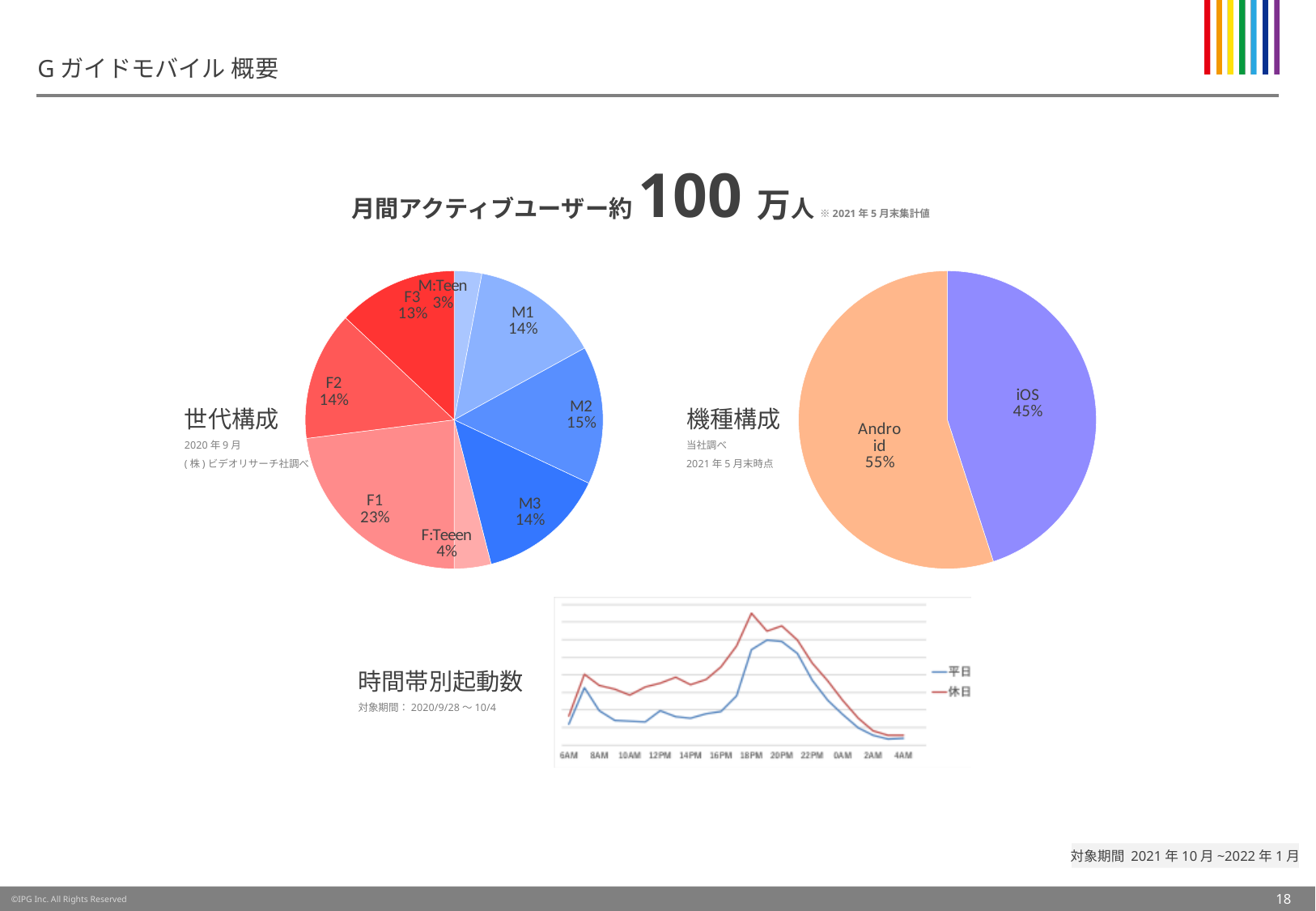
In the 世代構成 pie chart, what is the difference between the F1 share and the F3 share? 10% In the 機種構成 pie chart, what is the difference between the Android share and the iOS share? 10% How many series does the legend of the 時間帯別起動数 chart list? 2 In the 世代構成 pie chart, which segment is the smallest? M:Teen In the 機種構成 pie chart, which is larger, iOS or Android? Android In the 世代構成 pie chart, which is larger, M2 or F:Teeen? M2 What kind of chart is the 時間帯別起動数 chart? Line chart In the 世代構成 pie chart, which segment is the largest? F1 In the 世代構成 pie chart, what share does M2 have? 15% In the 世代構成 pie chart, what share does F1 have? 23% In the 機種構成 pie chart, what share does Android have? 55% In the 世代構成 pie chart, how many segments are there? 8